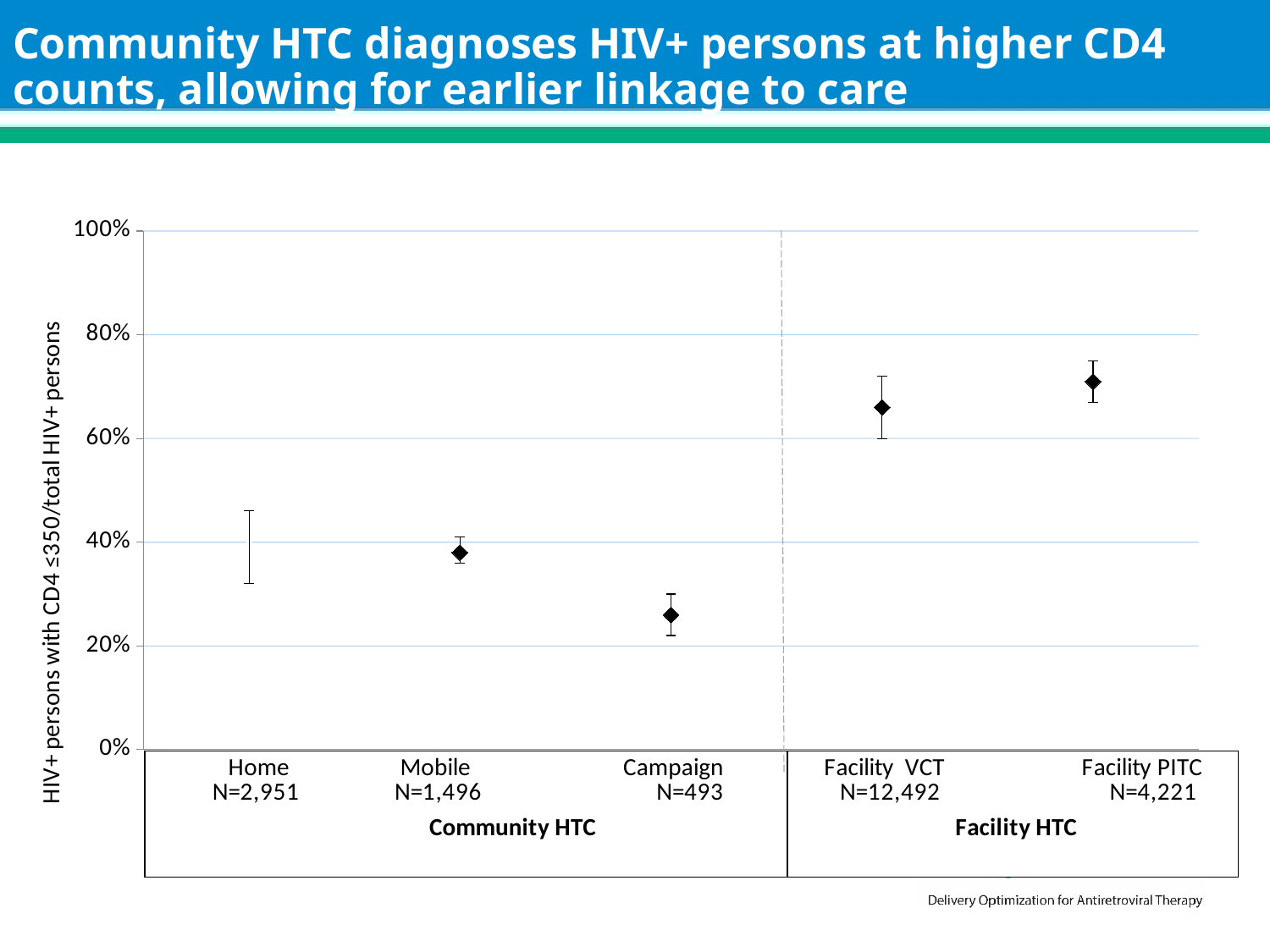
Is the value for Mobile greater or less than 60%? less Which category has the highest value? Facility PITC Is the value for Campaign greater or less than 20%? greater Which is larger, the value for Facility VCT or the value for Campaign? Facility VCT How many categories are plotted along the x axis? 5 Is the value for Facility VCT greater or less than 60%? greater What is the sample size (N) shown for the Facility VCT category? N=12,492 Which category has the lowest value? Campaign Which is larger, the value for Mobile or the value for Campaign? Mobile What kind of chart is shown on the slide? Scatter (point) chart with error bars